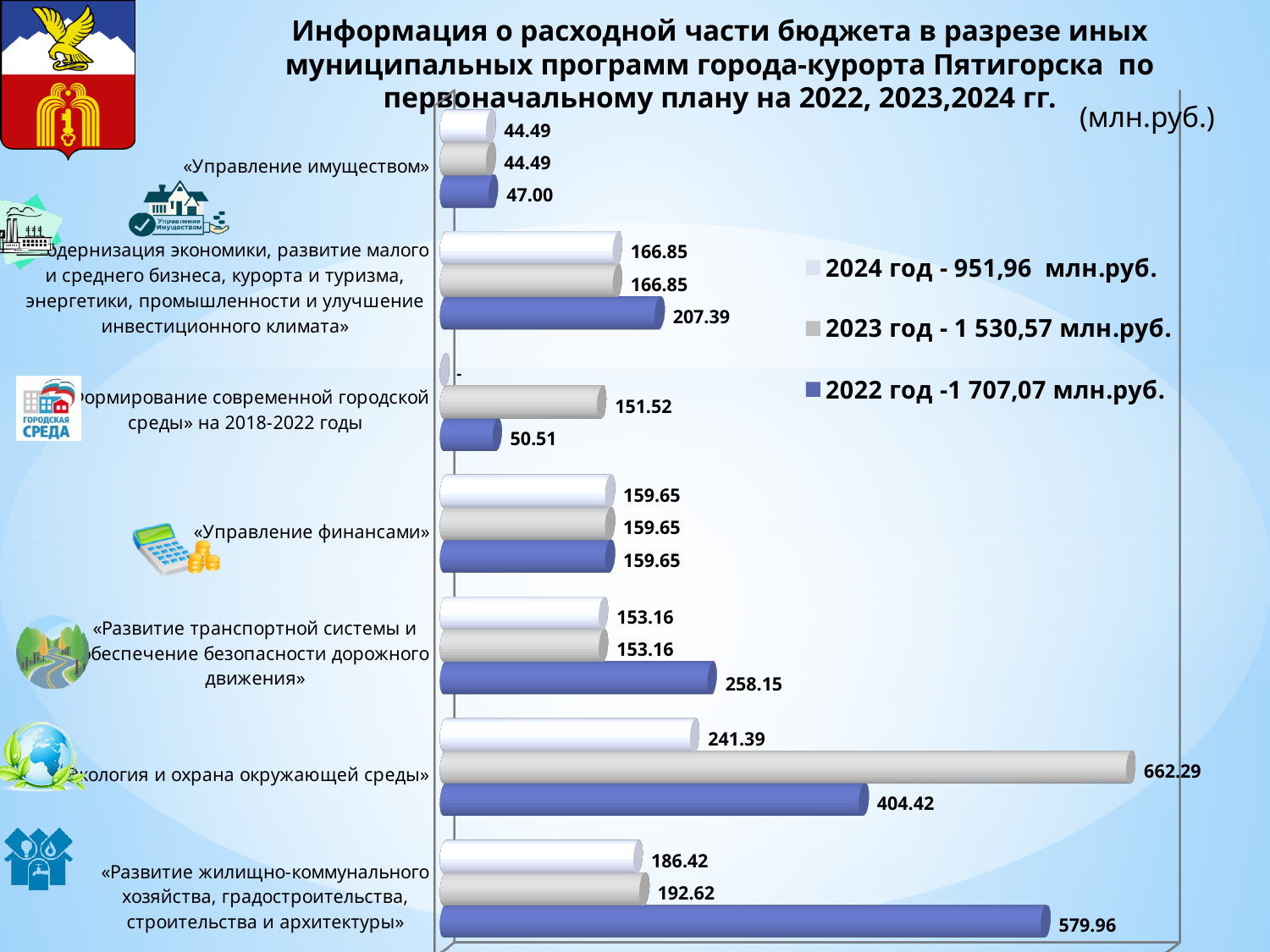
How many program categories are plotted on the chart? 7 What is the 2024 value for «Развитие жилищно-коммунального хозяйства, градостроительства, строительства и архитектуры»? 186.42 Which category has the lowest 2022 value? «Управление имуществом» What is the 2022 value for «Экология и охрана окружающей среды»? 404.42 What is the 2023 value for «Формирование современной городской среды» на 2018-2022 годы? 151.52 What is the difference between the 2022 and 2024 values for «Развитие транспортной системы и обеспечение безопасности дорожного движения»? 104.99 What type of chart is shown on the slide? bar chart How many series does the legend list? 3 Which category has the highest 2023 value? «Экология и охрана окружающей среды» Which is larger for «Экология и охрана окружающей среды»: the 2023 value or the 2022 value? 2023 What is the difference between the 2022 and 2023 values for «Развитие жилищно-коммунального хозяйства, градостроительства, строительства и архитектуры»? 387.34 What total for 2022 is shown in the legend? 1 707,07 млн.руб.